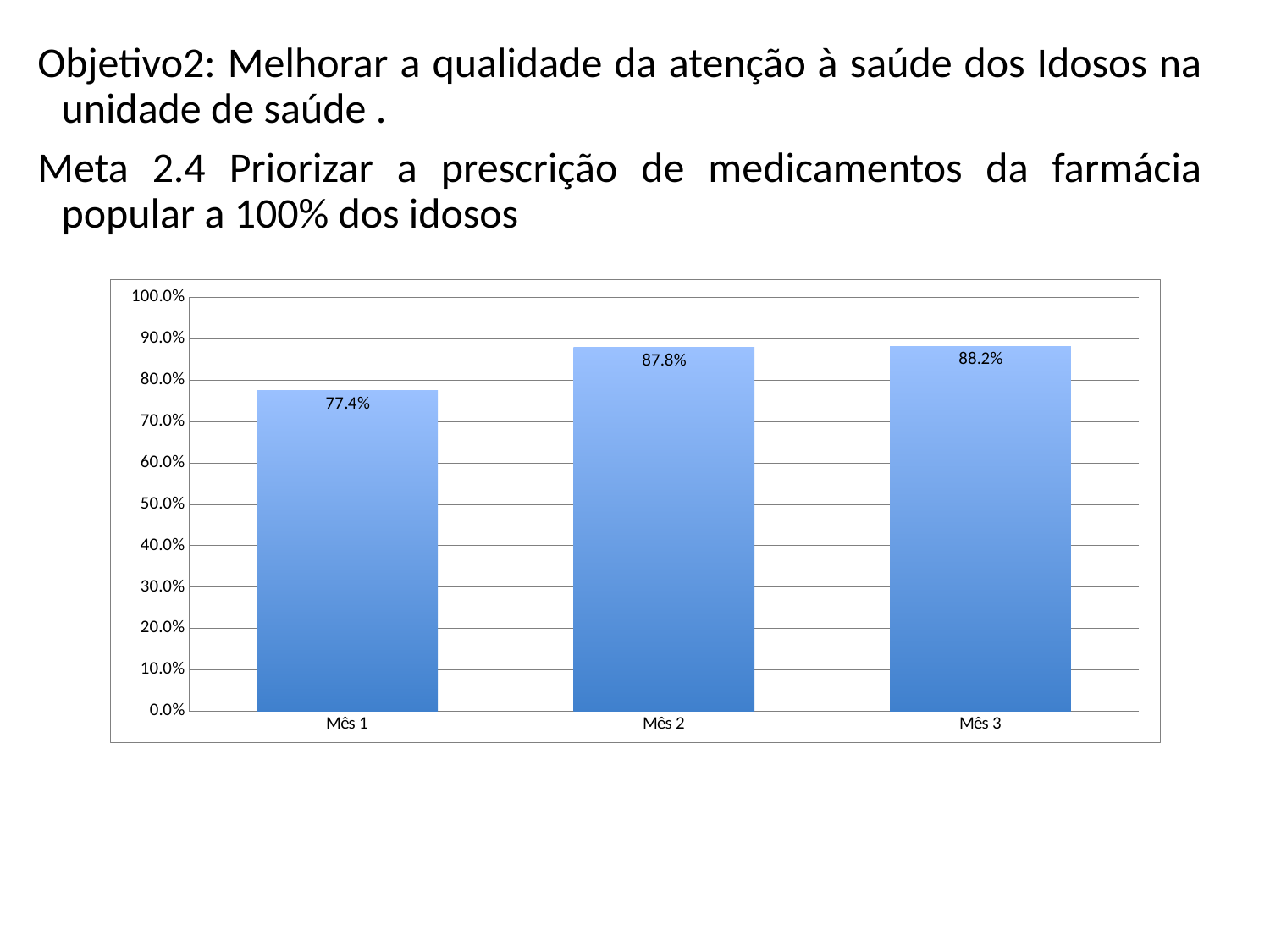
What is the value for Mês 3? 88.2% What kind of chart is shown on the slide? Bar chart Which month has the lowest value? Mês 1 Which month has the highest value according to the data labels? Mês 3 Is the value for Mês 1 greater or less than 80.0%? less What is the difference between the values for Mês 3 and Mês 1? 10.8 percentage points How many months are shown on the x axis? 3 What is the value for Mês 1? 77.4% What is the value for Mês 2? 87.8% What is the difference between the values for Mês 2 and Mês 1? 10.4 percentage points Is the value for Mês 3 greater or less than 90.0%? less Which is larger, the value for Mês 1 or the value for Mês 2? Mês 2